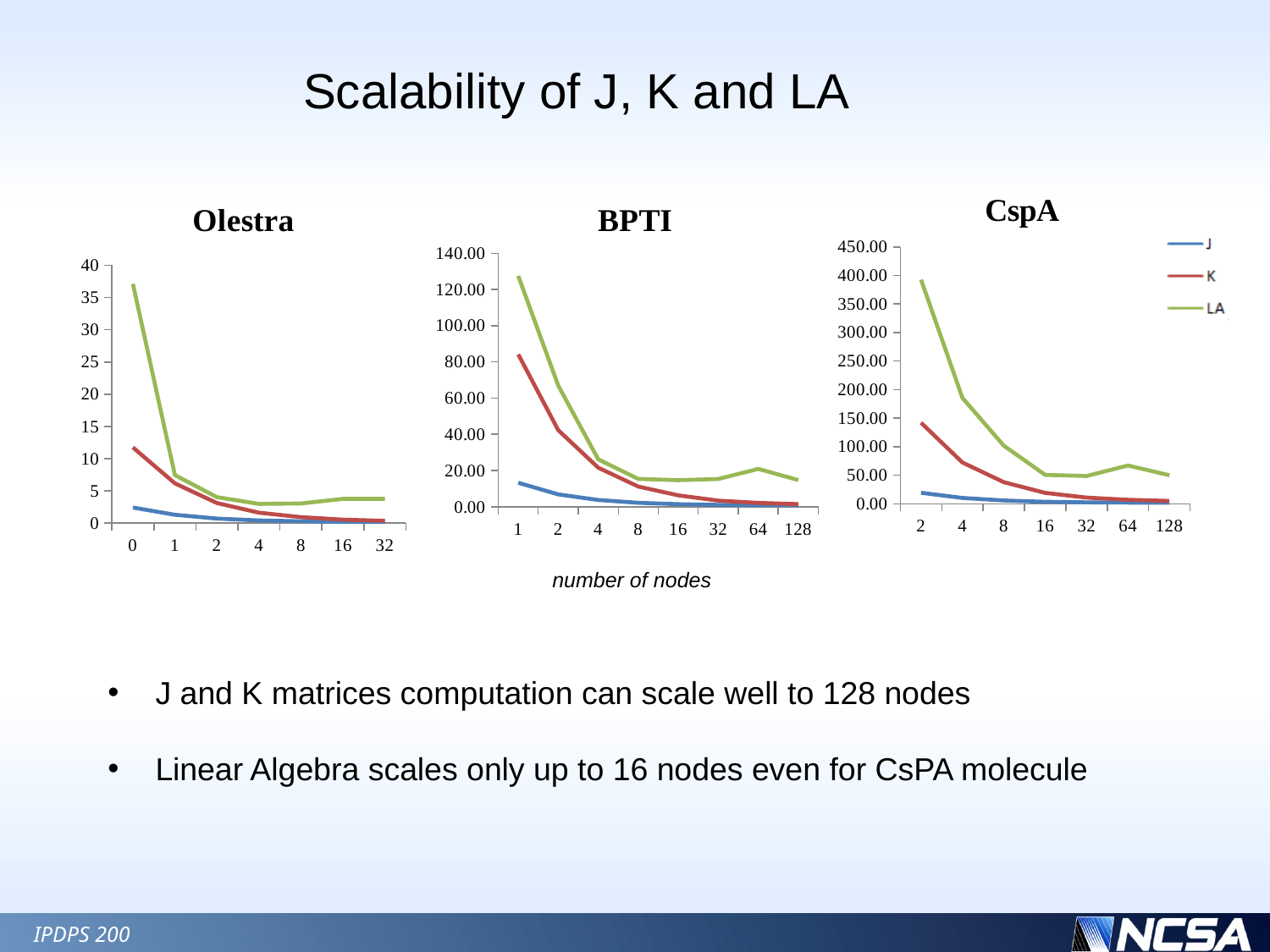
In the BPTI chart, how many node counts are plotted along the x axis? 8 In the CspA chart, how many node counts are plotted along the x axis? 7 In the CspA chart, is the value for LA at 2 nodes greater or less than 350.00? greater In the Olestra chart, how many node counts are plotted along the x axis? 7 In the CspA chart, is the value for K at 2 nodes greater or less than 100.00? greater In the Olestra chart, is the value for LA at 0 greater or less than 30? greater What kind of chart is the Olestra chart? line chart In the BPTI chart, which series has the highest value at 1 node? LA What is the title of the rightmost chart? CspA How many series does the legend list for the charts? 3 In the CspA chart, does the LA series rise or fall from 2 nodes to 16 nodes? fall